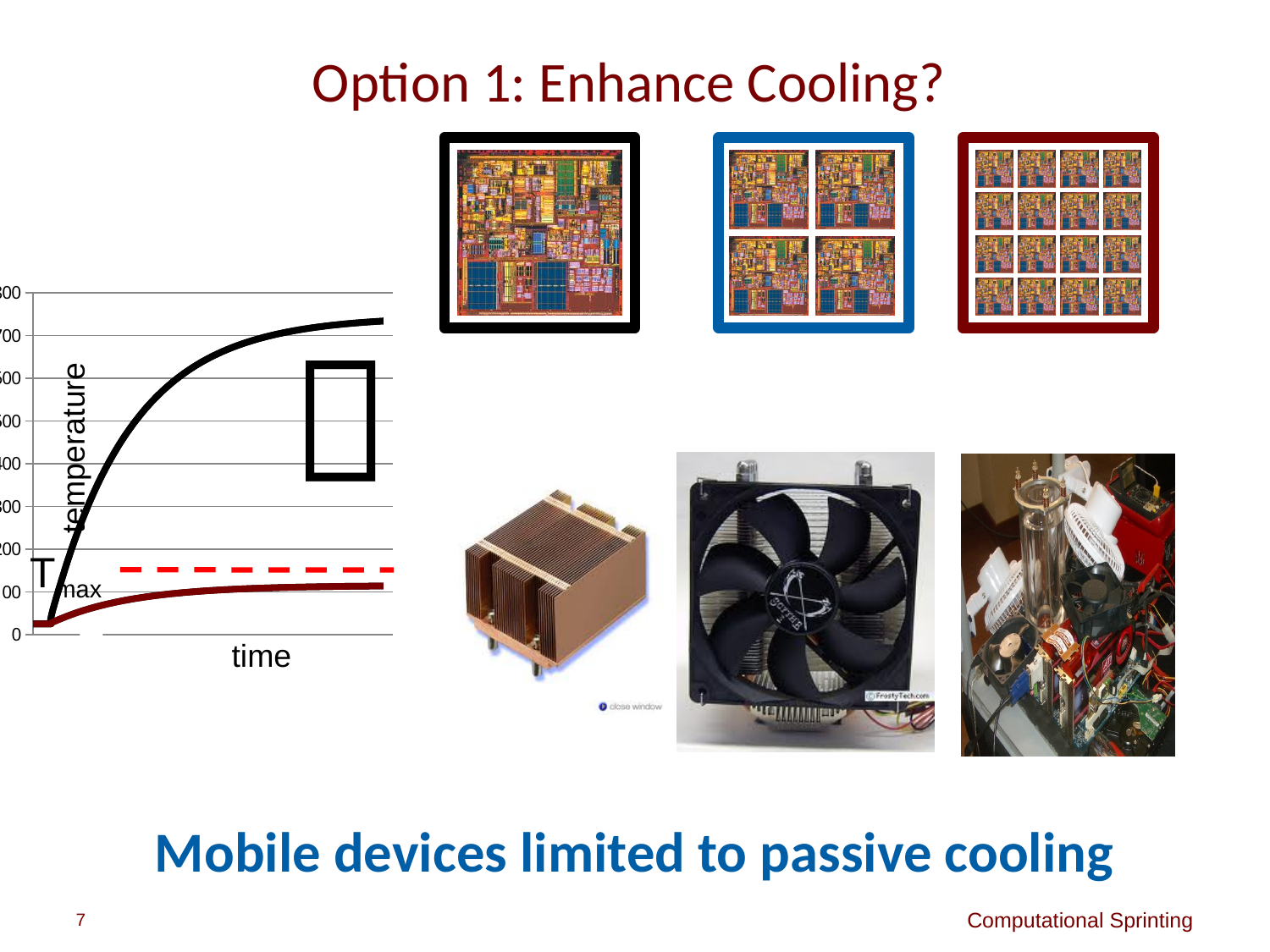
What is the label of the y axis of the chart? temperature Is the final value of the black curve greater or less than 700? greater Does the dark red solid curve stay above or below the dashed Tmax line? below What kind of chart is shown on the left of the slide? line chart Does the black curve rise or fall as time increases? rise What is the label of the x axis of the chart? time Which curve reaches a higher temperature, the black curve or the dark red solid curve? the black curve How many lines are plotted on the chart? 3 Is the final value of the dark red solid curve greater or less than 200? less Is the red dashed Tmax line greater or less than 200? less Is the black curve above or below the dashed Tmax line at the end of the time axis? above